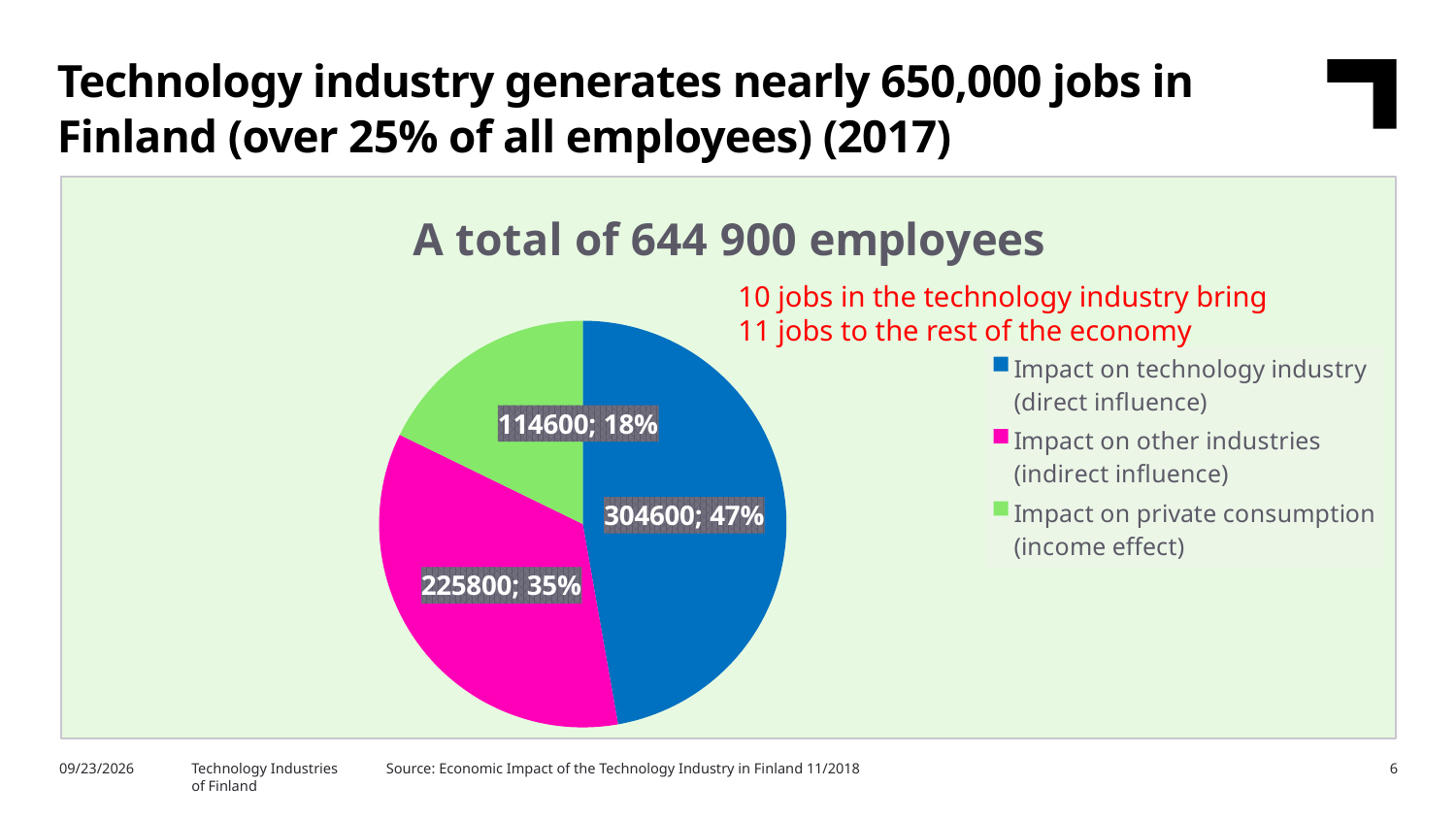
What is the value for Impact on private consumption (income effect)? 114600 What share of the pie does Impact on private consumption (income effect) represent? 18% What kind of chart is shown on the slide? Pie chart What is the value for Impact on other industries (indirect influence)? 225800 What share of the pie does Impact on other industries (indirect influence) represent? 35% Which is larger: Impact on other industries (indirect influence) or Impact on private consumption (income effect)? Impact on other industries (indirect influence) Which category has the smallest slice of the pie? Impact on private consumption (income effect) What is the value for Impact on technology industry (direct influence)? 304600 How many slices does the pie chart have? 3 Which category has the largest slice of the pie? Impact on technology industry (direct influence) What is the difference between the values for Impact on technology industry (direct influence) and Impact on other industries (indirect influence)? 78800 What is the title of the chart? A total of 644 900 employees